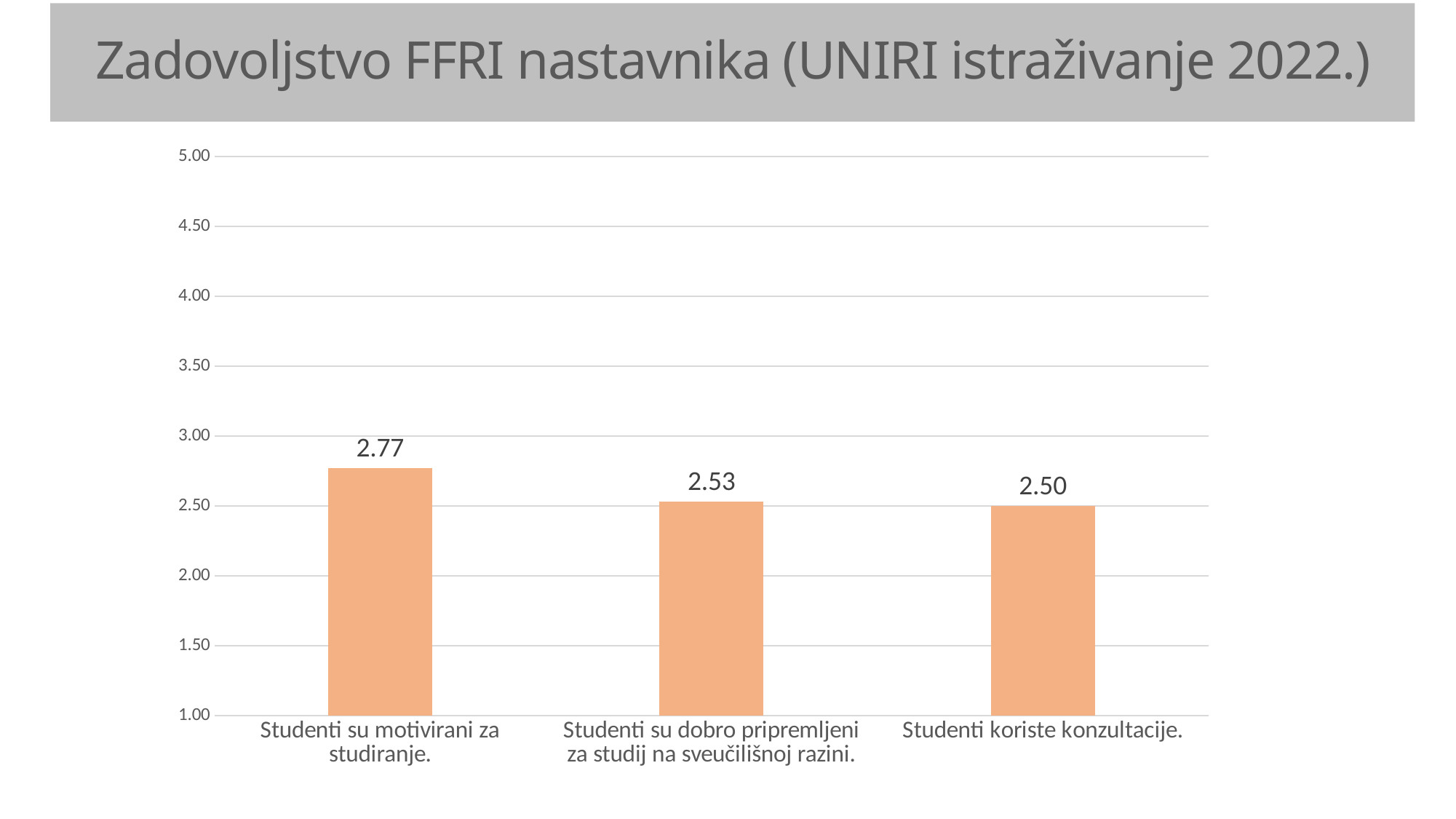
What is the difference between the values for "Studenti su motivirani za studiranje." and "Studenti koriste konzultacije."? 0.27 What is the title of the slide? Zadovoljstvo FFRI nastavnika (UNIRI istraživanje 2022.) What is the difference between the values for "Studenti su motivirani za studiranje." and "Studenti su dobro pripremljeni za studij na sveučilišnoj razini."? 0.24 What kind of chart is shown on the slide? bar chart Is the value for "Studenti su motivirani za studiranje." greater or less than 3.00? less What is the value for "Studenti koriste konzultacije."? 2.50 How many categories are shown in the chart? 3 Which is larger: the value for "Studenti su motivirani za studiranje." or the value for "Studenti su dobro pripremljeni za studij na sveučilišnoj razini."? Studenti su motivirani za studiranje. What is the value for "Studenti su dobro pripremljeni za studij na sveučilišnoj razini."? 2.53 What is the value for "Studenti su motivirani za studiranje."? 2.77 Which category has the lowest value? Studenti koriste konzultacije. Which category has the highest value? Studenti su motivirani za studiranje.